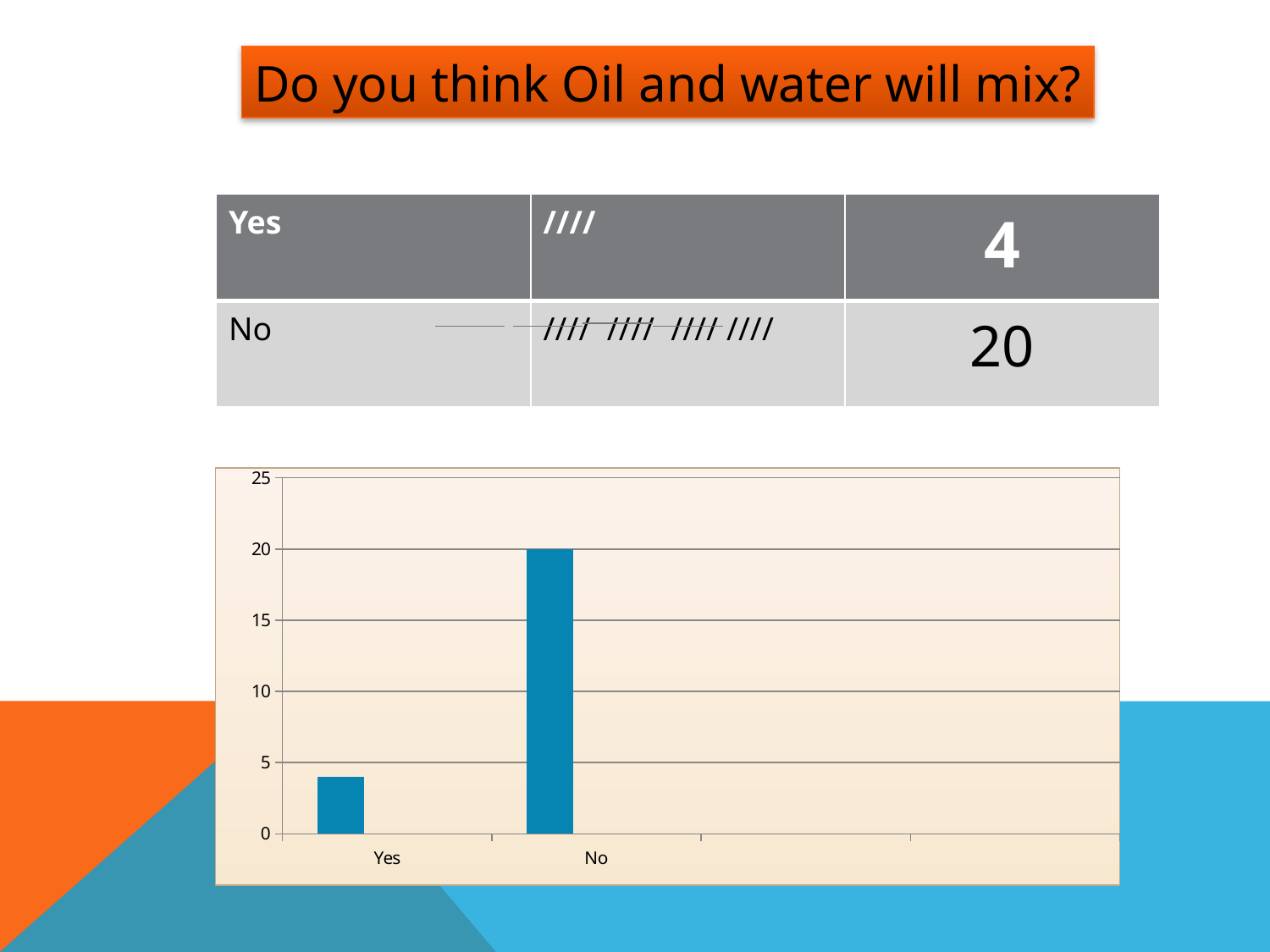
Is the bar for Yes greater or less than 5? less What is the difference between the No value and the Yes value? 16 What is the value of the bar for No? 20 Which is larger, the bar for Yes or the bar for No? No Is the bar for No greater or less than 15? greater How many categories are shown on the x axis of the chart? 2 What question does the slide title ask? Do you think Oil and water will mix? Which category has the lowest bar? Yes Which category has the highest bar? No What kind of chart is shown on the slide? bar chart What is the highest value shown on the chart's vertical axis? 25 What is the value of the bar for Yes? 4